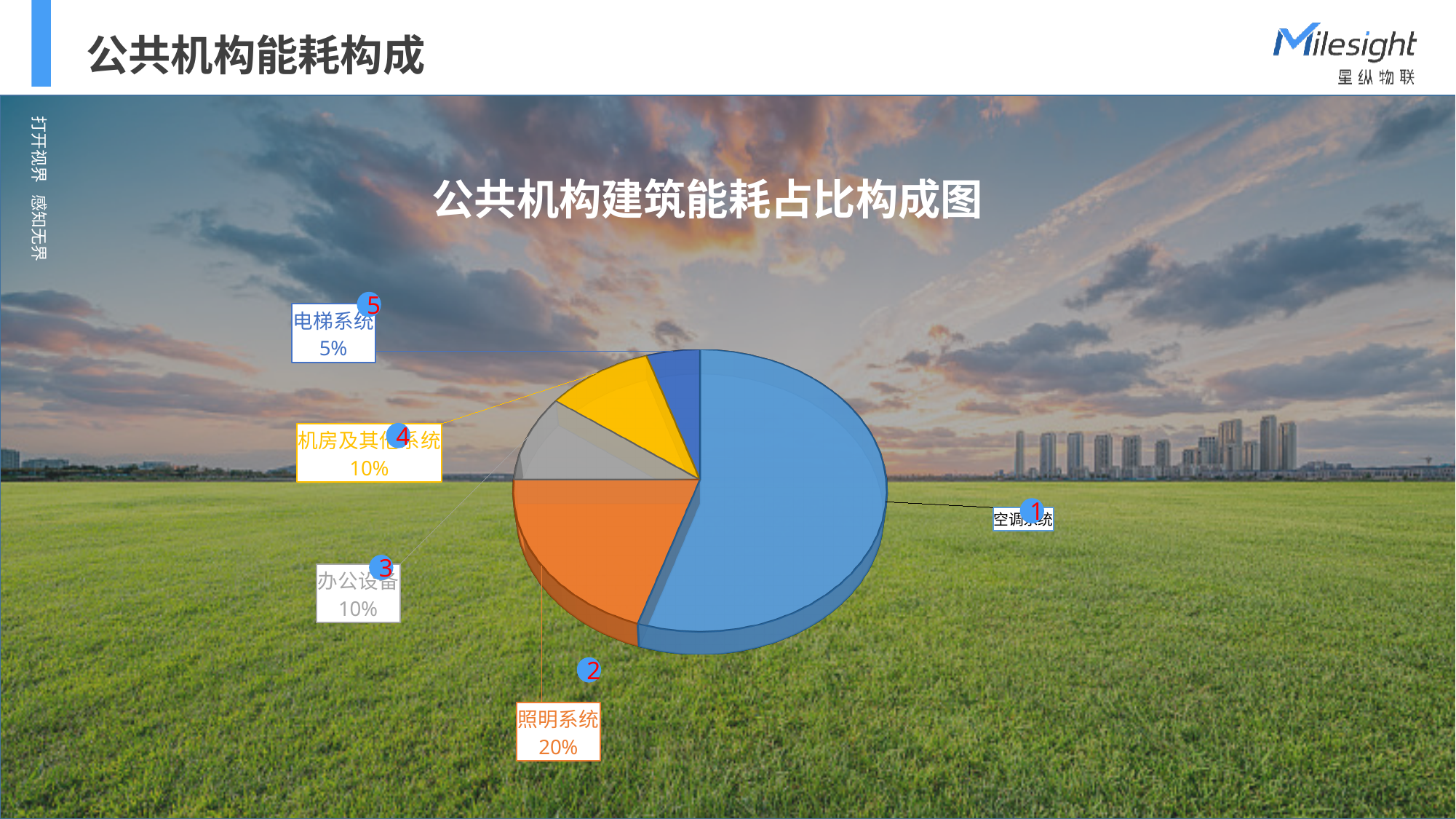
What percentage is shown for 办公设备? 10% Which category has the smallest slice of the pie? 电梯系统 What colour is the 照明系统 slice? orange How much larger is the share of 照明系统 than that of 电梯系统? 15% What is the title of the chart? 公共机构建筑能耗占比构成图 What is the value shown for 电梯系统? 5% What kind of chart is shown on the slide? pie chart How many slices does the pie chart have? 5 Which category has the largest slice of the pie? 空调系统 Which has a larger share, 照明系统 or 办公设备? 照明系统 What percentage is shown for 机房及其他系统? 10% What share of energy consumption does 照明系统 account for? 20%